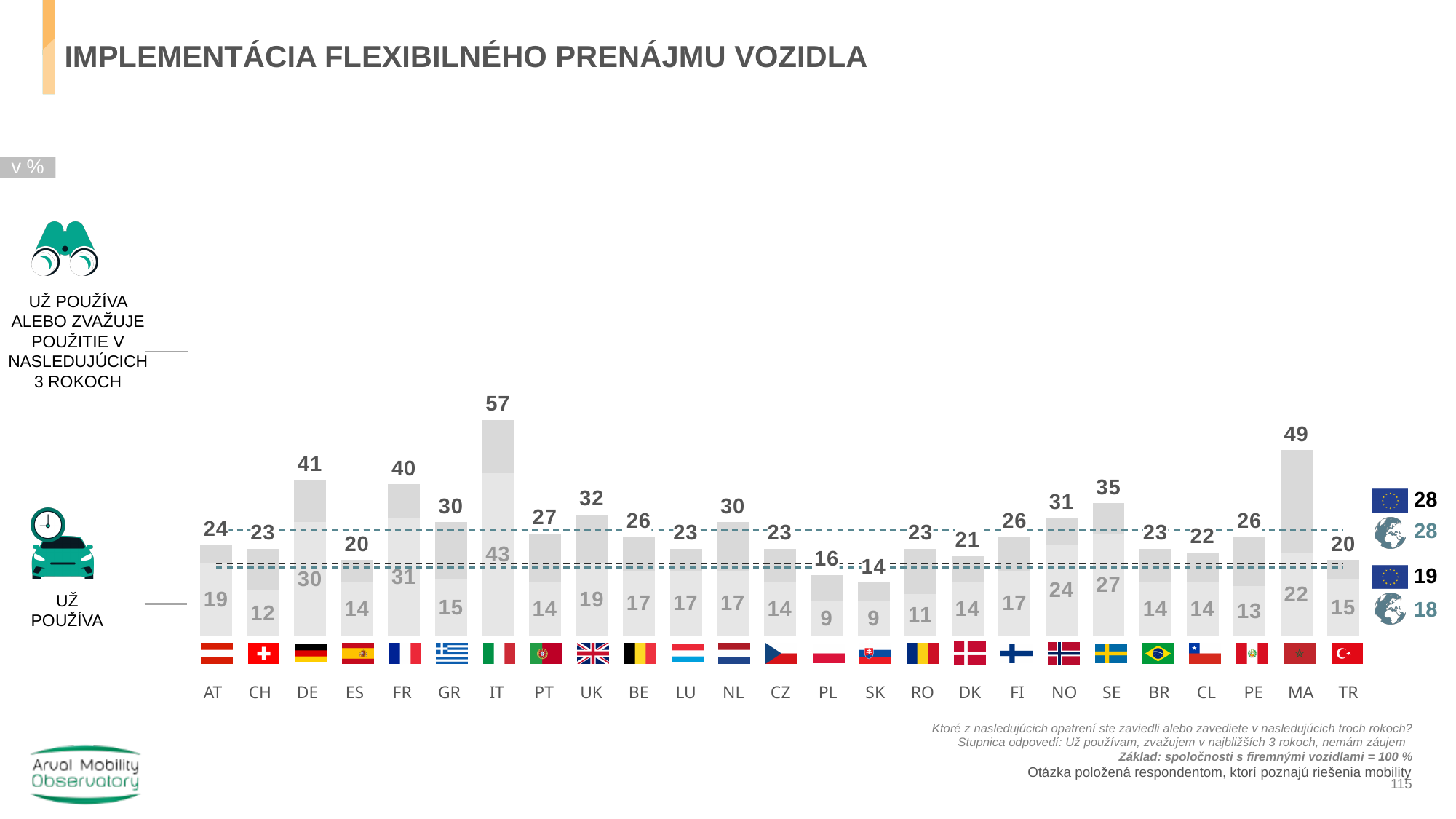
Which country has the lowest value for already using or considering flexible vehicle rental in the next 3 years? SK Which country has the highest value for already using or considering flexible vehicle rental in the next 3 years? IT How many countries are shown on the x axis of the chart? 25 What percentage of companies in IT already use or are considering flexible vehicle rental in the next 3 years? 57 What kind of chart is shown on the slide? Bar chart What percentage of companies in DE already use flexible vehicle rental ("Už používa")? 30 What is the EU average value shown for "already uses" ("Už používa") flexible vehicle rental? 19 What is the global average value shown for "already uses or considers" flexible vehicle rental in the next 3 years? 28 What is the "already uses" ("Už používa") value for PL? 9 Which is larger: the "already uses or considers" value for SE or for NO? SE What is the difference between the "already uses or considers" value for MA and the "already uses" value for MA? 27 Which country has the highest value for already using flexible vehicle rental ("Už používa")? IT